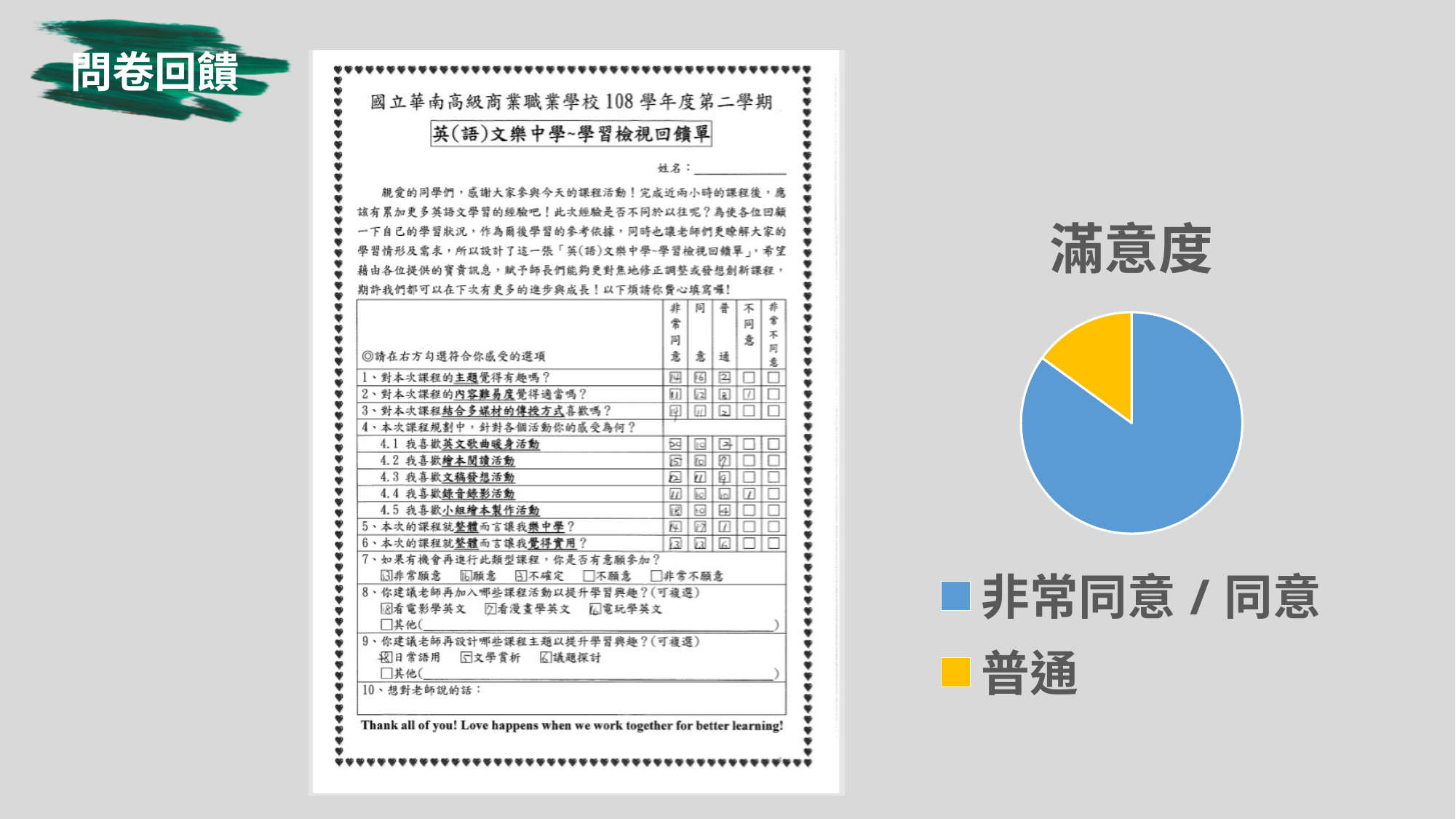
What kind of chart is shown on the slide? pie chart Which category has the smallest slice in the pie chart? 普通 How many slices does the pie chart have? 2 What colour is the slice for 普通 in the pie chart? yellow Which slice is larger, 非常同意 / 同意 or 普通? 非常同意 / 同意 What is the title of the pie chart? 滿意度 Which category has the largest slice in the pie chart? 非常同意 / 同意 How many entries does the legend of the pie chart list? 2